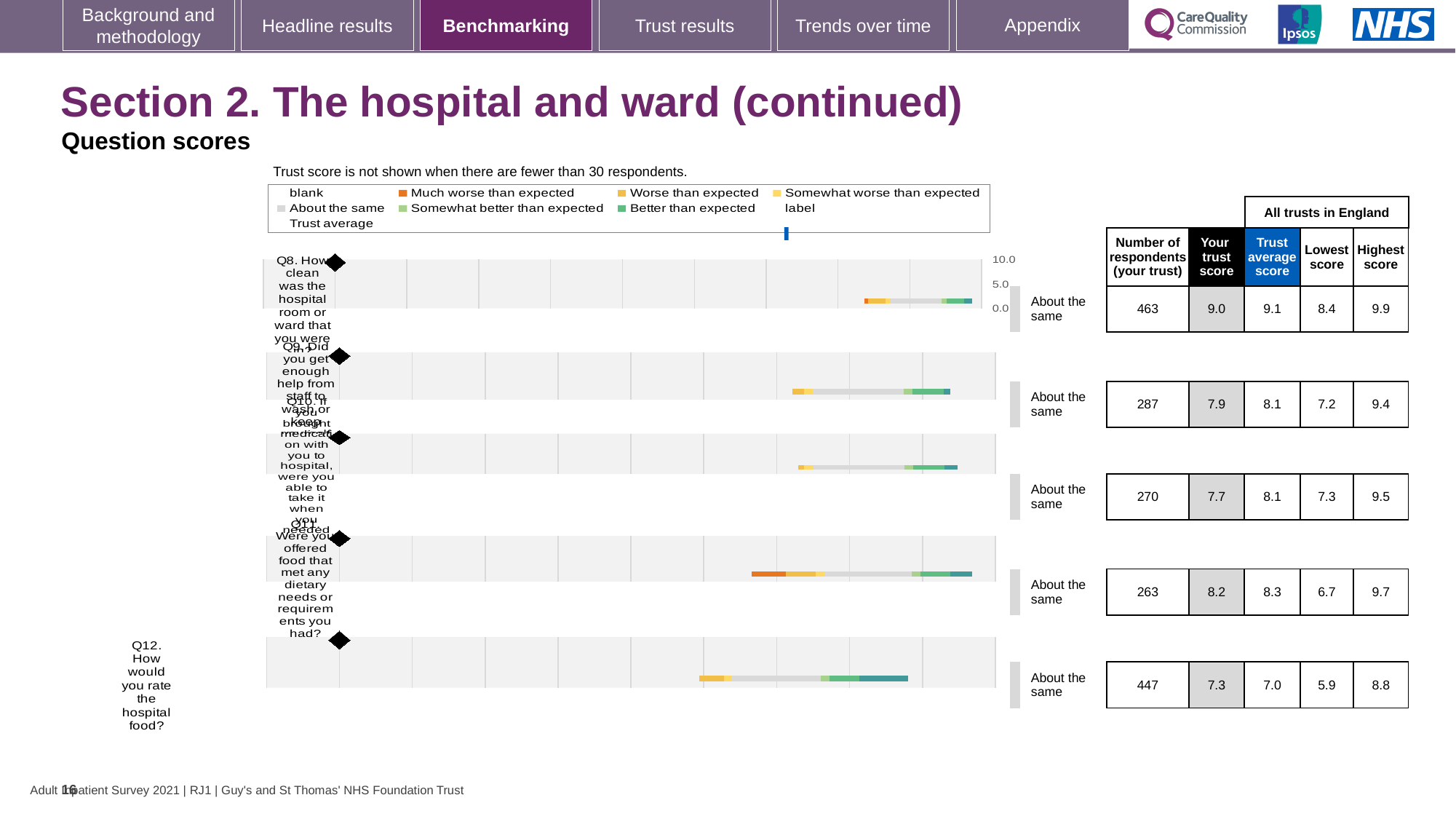
What is the difference between the trust score for Q8 and the trust score for Q12? 1.7 What is the lowest score across all trusts in England for Q12? 5.9 Which question has the highest trust score? Q8 What is the trust average score for Q9 (did you get enough help from staff to wash or keep yourself clean)? 8.1 What benchmark category is shown for Q10 (were you able to take your own medication when you needed to)? About the same What kind of chart is used to show the question scores on this slide? bar chart What is the trust score for Q8 (how clean was the hospital room or ward)? 9.0 How many respondents answered Q12 (how would you rate the hospital food)? 447 What is the highest score across all trusts in England for Q11 (were you offered food that met any dietary needs)? 9.7 How many questions (Q8 to Q12) are plotted on the chart? 5 For Q12, which is larger: the trust score or the trust average score? the trust score (7.3) Which question has the lowest trust score? Q12